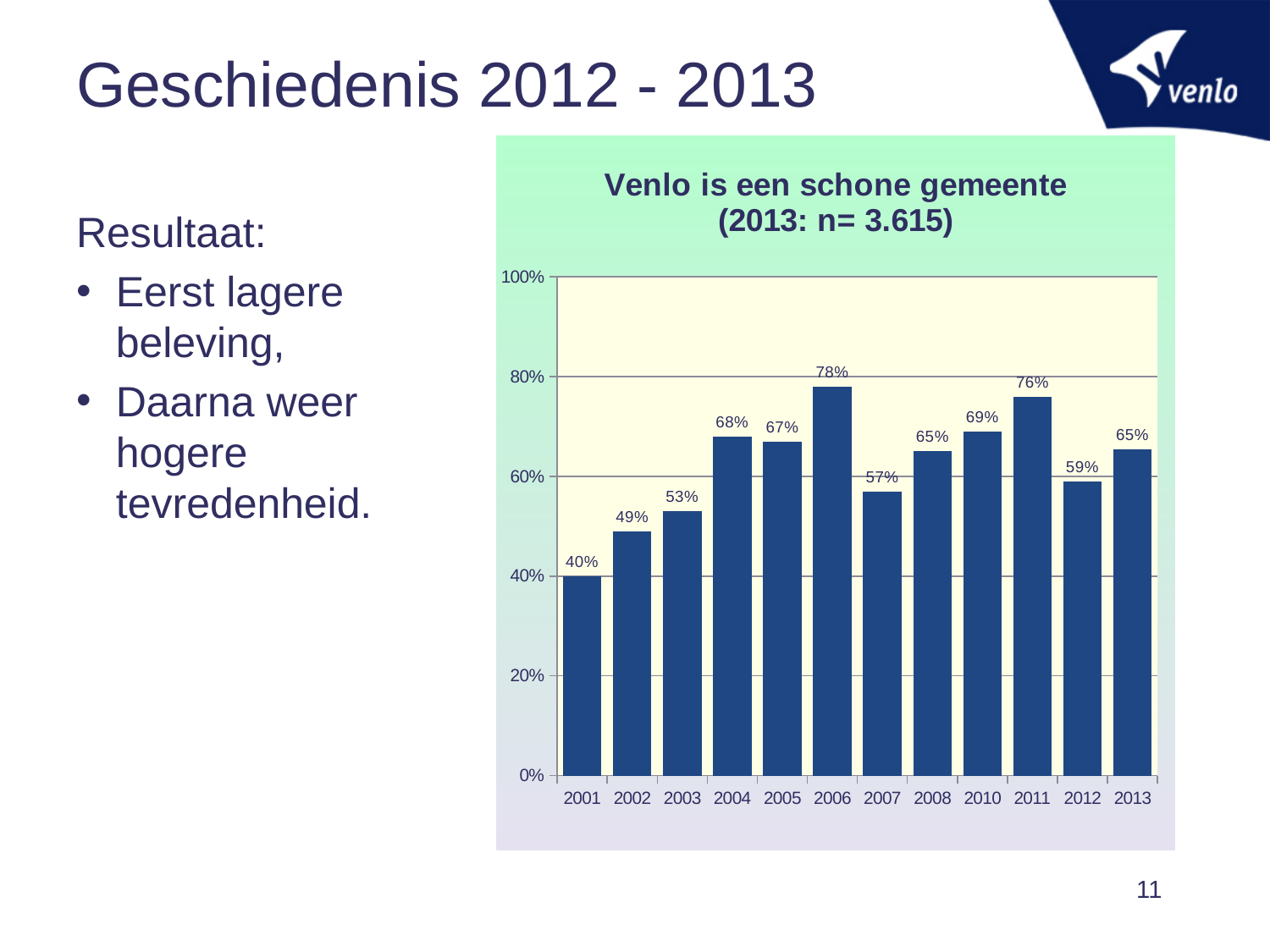
How many years are shown on the x axis? 12 What kind of chart is this? bar chart What is the title of the chart? Venlo is een schone gemeente (2013: n= 3.615) Do the values rise or fall from 2001 to 2006? rise What is the value for 2006? 78% What is the difference between the values for 2011 and 2012? 17% Which year has the highest value? 2006 What is the value for 2001? 40% Is the value for 2007 greater or less than 60%? less Which is larger, the value for 2004 or the value for 2010? 2010 Which year has the lowest value? 2001 What is the value for 2012? 59%